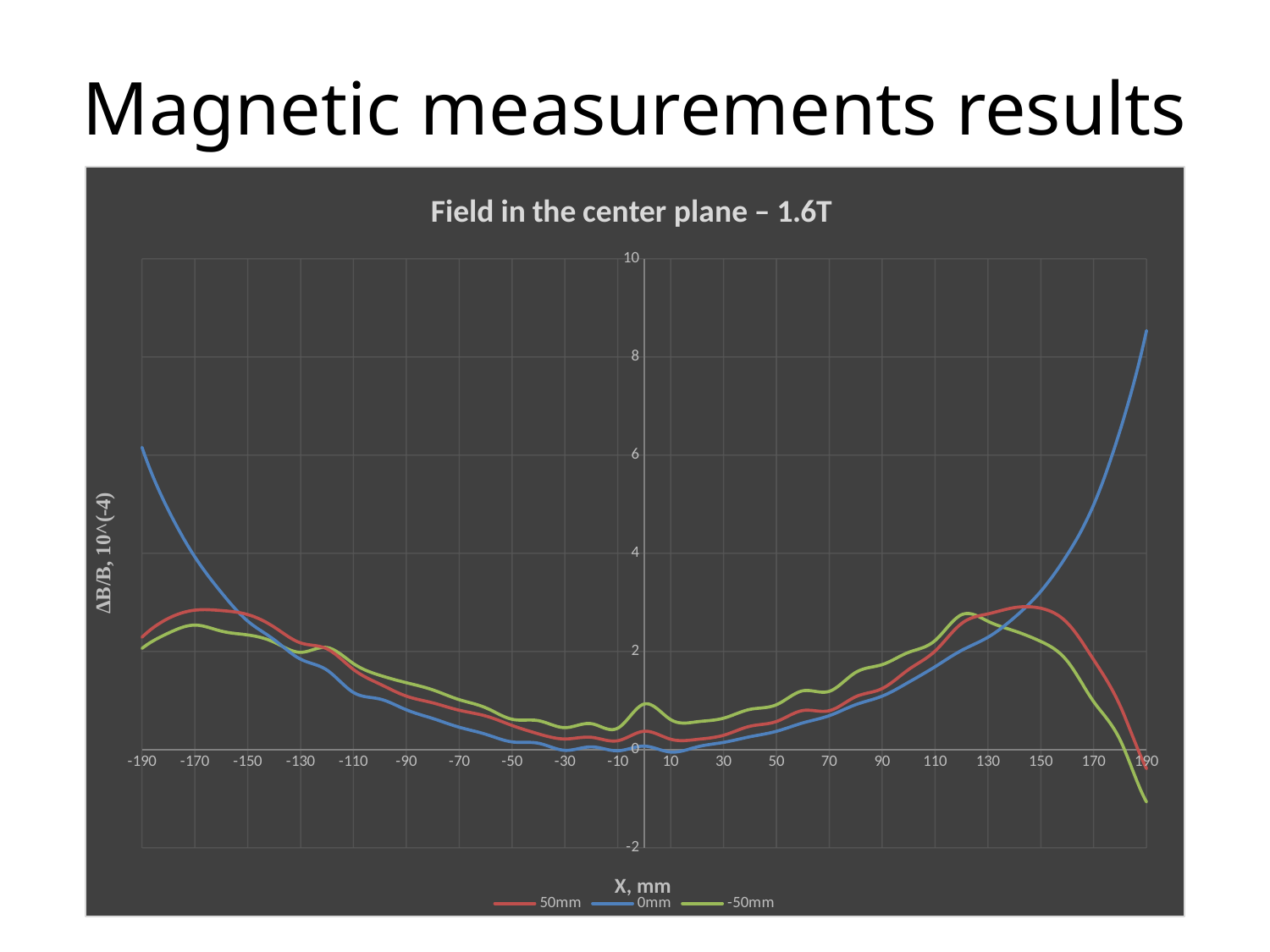
What is the title of the chart? Field in the center plane – 1.6T How many series does the legend list? 3 Which series reaches the highest value on the chart? 0mm What kind of chart is shown on the slide? Line chart At X = 190, which series has the larger value, 0mm or -50mm? 0mm Which series reaches the lowest value on the chart? -50mm At X = 150, which series has the larger value, 50mm or -50mm? 50mm Does the 0mm series rise or fall as X increases from 10 to 190? rise Is the value of the 0mm series at X = 190 greater or less than 8? greater What is the label of the x axis? X, mm Is the value of the 0mm series at X = -190 greater or less than 4? greater Is the value of the -50mm series at X = 190 greater or less than 0? less